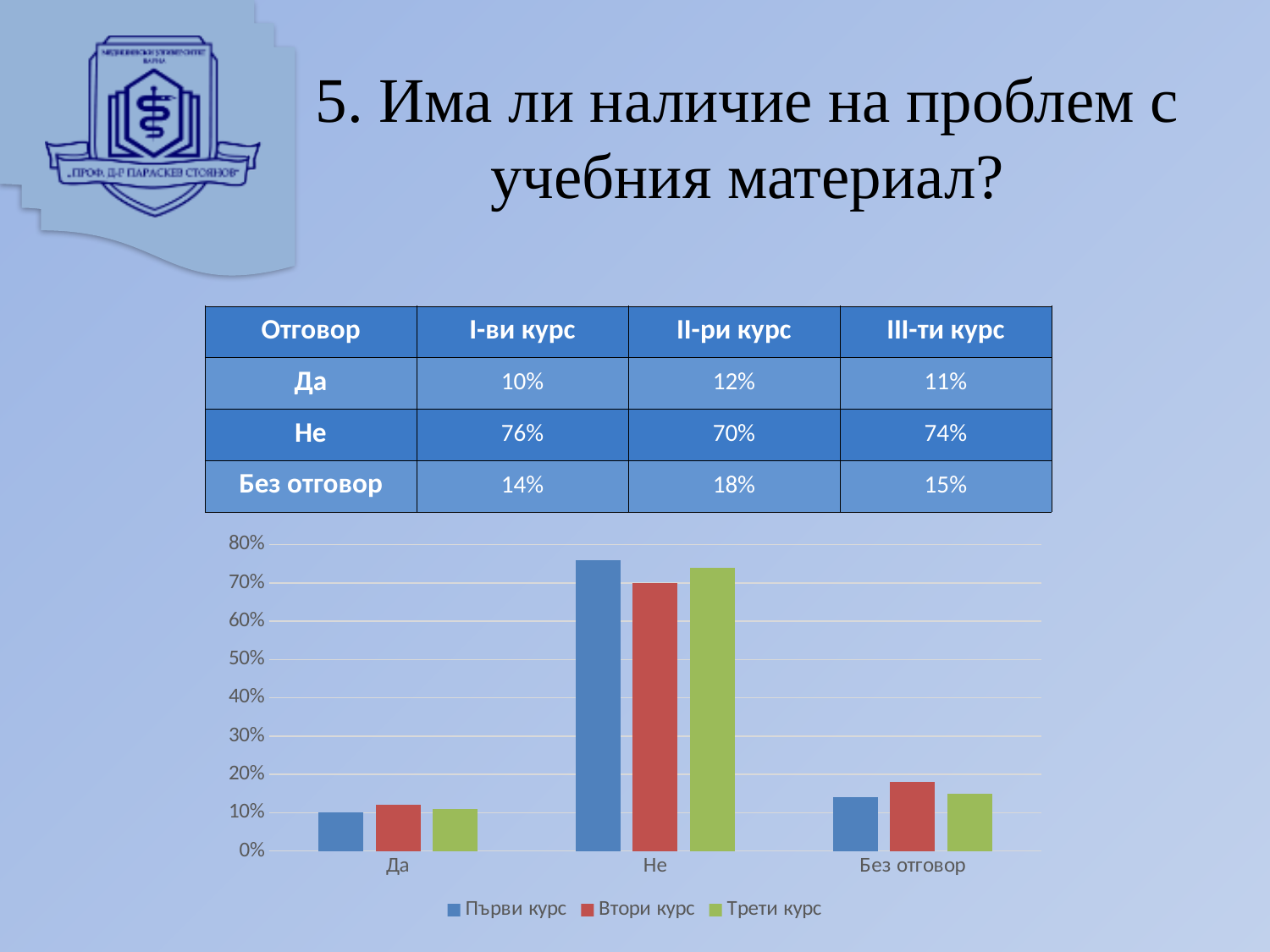
Which colour represents Трети курс in the chart? green Which category has the highest values across all series? Не Which series has the lowest value in the Не category? Втори курс What is the value for Втори курс in the Без отговор category? 18% Is the value for Трети курс in the Не category greater or less than 60%? greater What is the value for Първи курс in the Не category? 76% What is the difference between Първи курс and Втори курс in the Не category? 6% What type of chart is shown on the slide? bar chart Which is larger in the Без отговор category: Втори курс or Трети курс? Втори курс What is the value for Трети курс in the Да category? 11% How many series does the chart legend list? 3 How many categories are shown on the x axis of the chart? 3